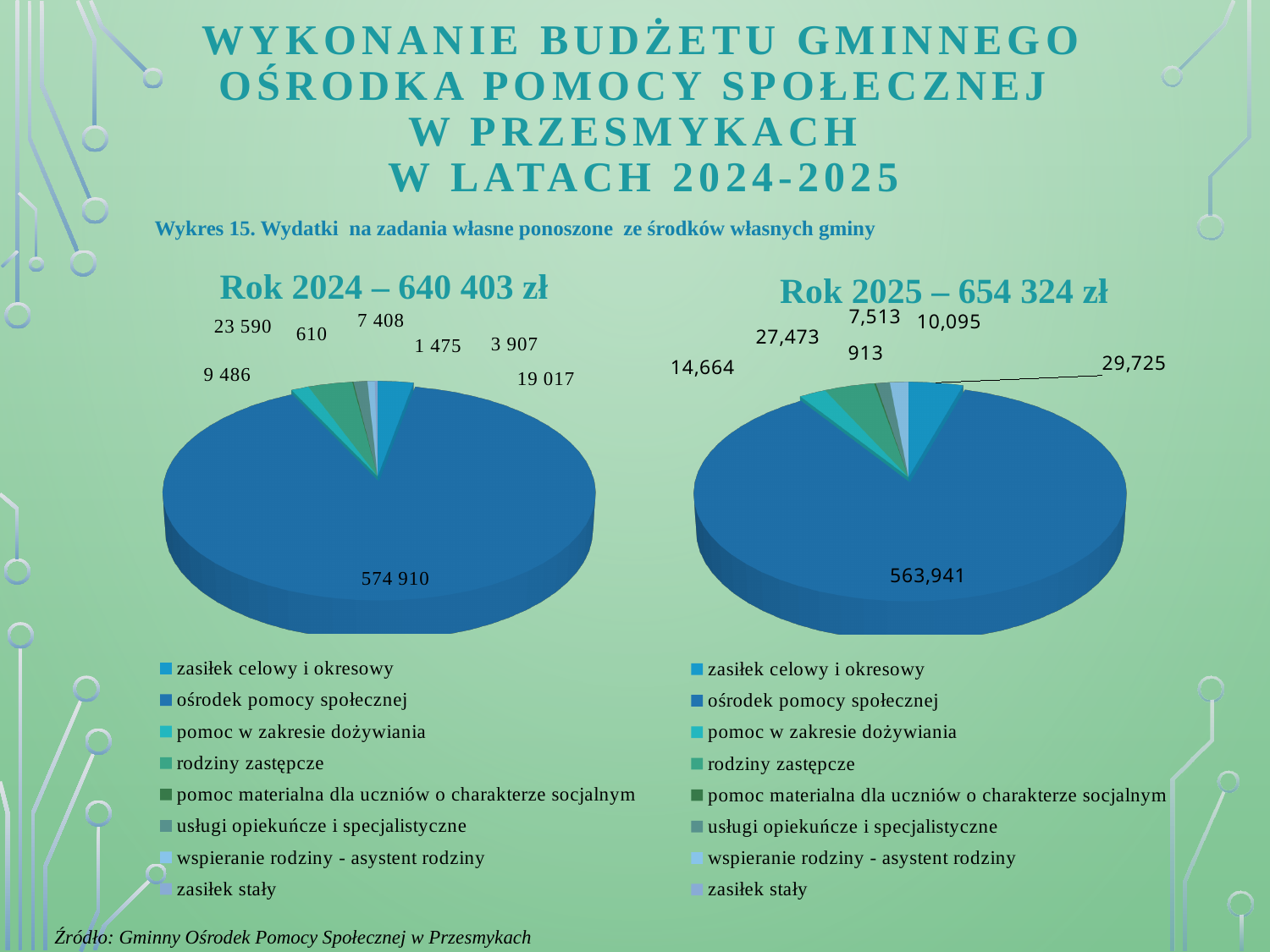
How many categories does the legend of the 'Rok 2025 – 654 324 zł' chart list? 8 What is the caption (Wykres number) given for the charts on this slide? Wykres 15. Wydatki na zadania własne ponoszone ze środków własnych gminy In the 'Rok 2024 – 640 403 zł' chart, which category does the largest slice represent? ośrodek pomocy społecznej Which is larger: the largest slice in the 'Rok 2024 – 640 403 zł' chart or the largest slice in the 'Rok 2025 – 654 324 zł' chart? Rok 2024 (574 910) What is the difference between the largest slice of the 'Rok 2024 – 640 403 zł' chart (574 910) and the largest slice of the 'Rok 2025 – 654 324 zł' chart (563,941)? 10 969 In the 'Rok 2025 – 654 324 zł' chart, what is the value of the largest slice? 563,941 In the 'Rok 2024 – 640 403 zł' chart, what is the value of the largest slice? 574 910 In the 'Rok 2024 – 640 403 zł' chart, what is the smallest value shown? 610 What kind of chart is used for the 'Rok 2024 – 640 403 zł' chart? pie chart In the 'Rok 2025 – 654 324 zł' chart, what is the smallest value shown? 913 What is the total budget shown in the title of the left chart for Rok 2024? 640 403 zł What is the difference between the total for Rok 2025 (654 324 zł) and the total for Rok 2024 (640 403 zł) shown in the chart titles? 13 921 zł